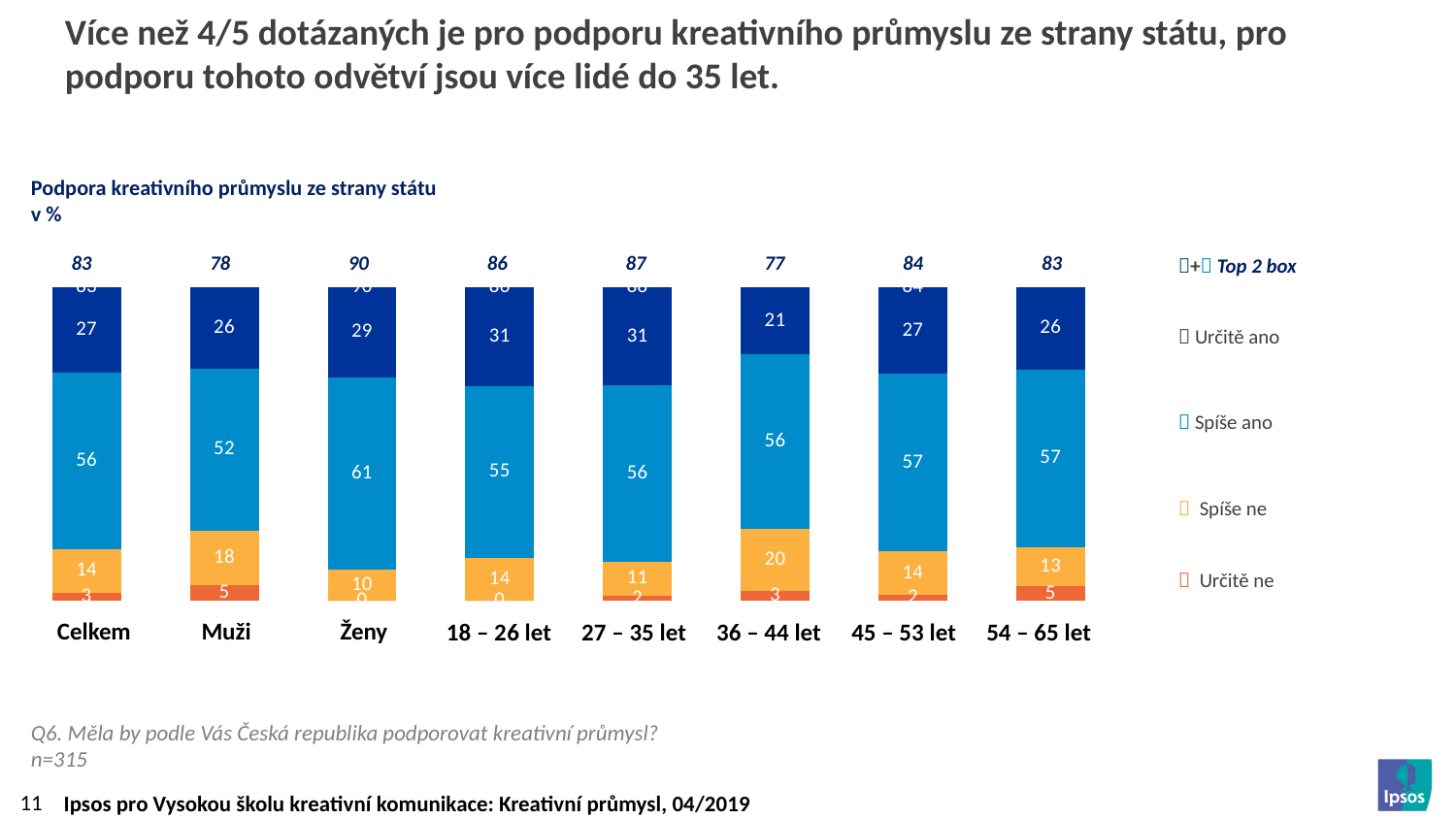
What percentage of the 36 – 44 let group answered Spíše ne? 20 What type of chart is shown on the slide? Stacked bar chart What is the Top 2 box value for Ženy? 90 What is the difference between the Top 2 box values for Ženy and Muži? 12 What is the total of Určitě ano and Spíše ano for the 27 – 35 let bar? 87 Which has a larger Spíše ano value, Celkem or Ženy? Ženy Which category has the highest Top 2 box value? Ženy What is the Určitě ano value for the 18 – 26 let group? 31 Which legend entry is shown in dark blue? Určitě ano How many categories are shown on the x axis? 8 What is the title of the chart? Podpora kreativního průmyslu ze strany státu Which category has the lowest Top 2 box value? 36 – 44 let